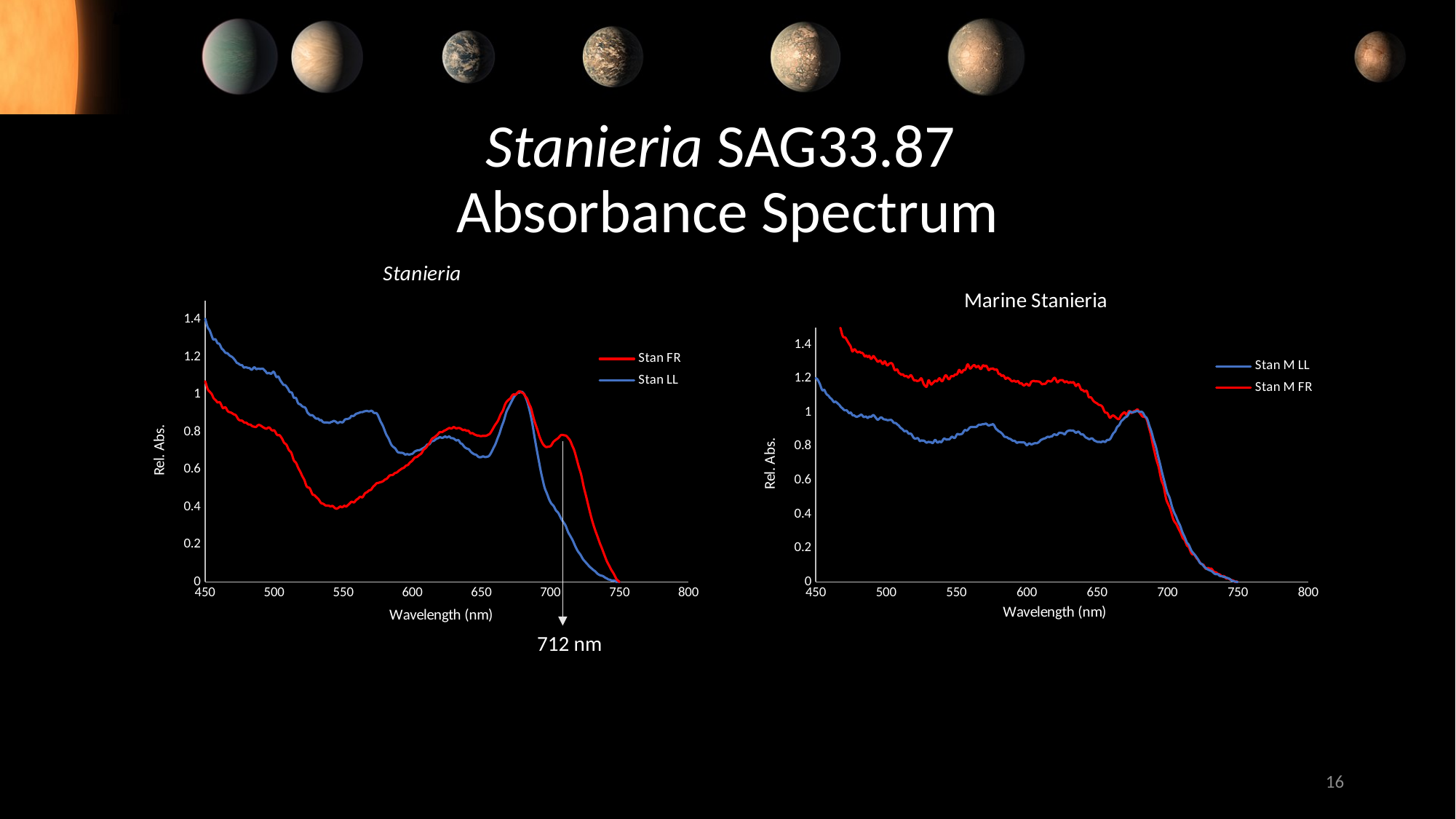
How many series does the legend of the Marine Stanieria chart list? 2 In the Stanieria chart on the left, which series is drawn in red? Stan FR In the Stanieria chart on the left, is the value of Stan LL at 450 nm greater or less than 1.2? greater In the Marine Stanieria chart on the right, at 600 nm which series has the larger value, Stan M LL or Stan M FR? Stan M FR In the Stanieria chart on the left, is the value of Stan FR at 550 nm greater or less than 0.6? less In the Stanieria chart on the left, what wavelength does the arrow annotation point to? 712 nm In the Marine Stanieria chart on the right, is the value of Stan M LL at 550 nm greater or less than 1? less In the Stanieria chart on the left, at 550 nm which series has the larger value, Stan FR or Stan LL? Stan LL What kind of chart is the Stanieria chart on the left? line chart In the Marine Stanieria chart on the right, do the values of Stan M LL rise or fall between 700 nm and 750 nm? fall